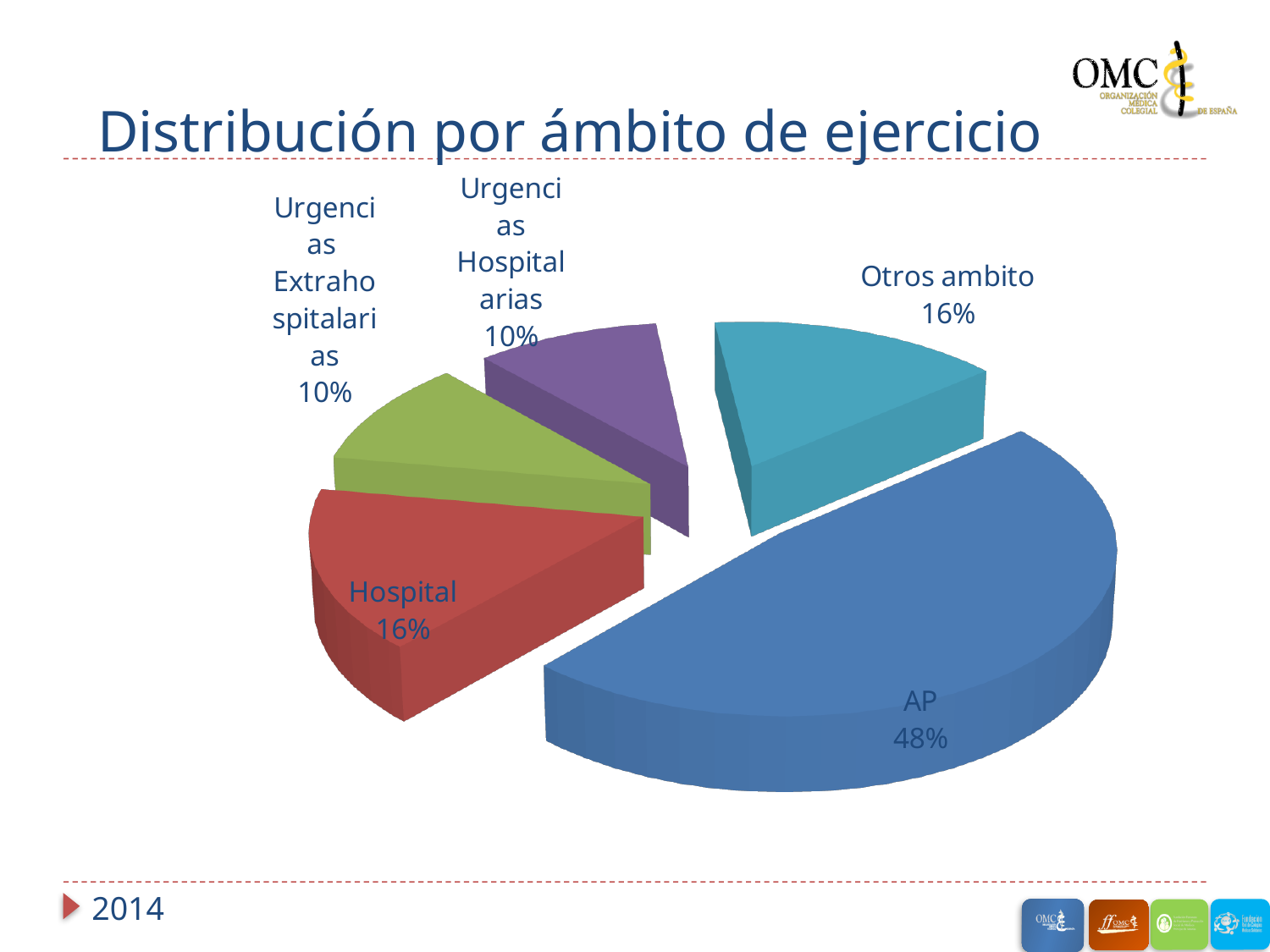
What is the difference in percentage points between AP and Hospital? 32 What is the title of the chart on the slide? Distribución por ámbito de ejercicio What percentage is shown for Urgencias Hospitalarias? 10% What colour is the AP slice of the pie? blue Which is larger, the share for AP or the share for Otros ambito? AP What percentage is shown for Urgencias Extrahospitalarias? 10% What share of the pie does AP represent? 48% Which category has the largest slice of the pie? AP What percentage is shown for Hospital? 16% How many slices does the pie chart have? 5 What percentage is shown for Otros ambito? 16% What kind of chart is shown on the slide? pie chart